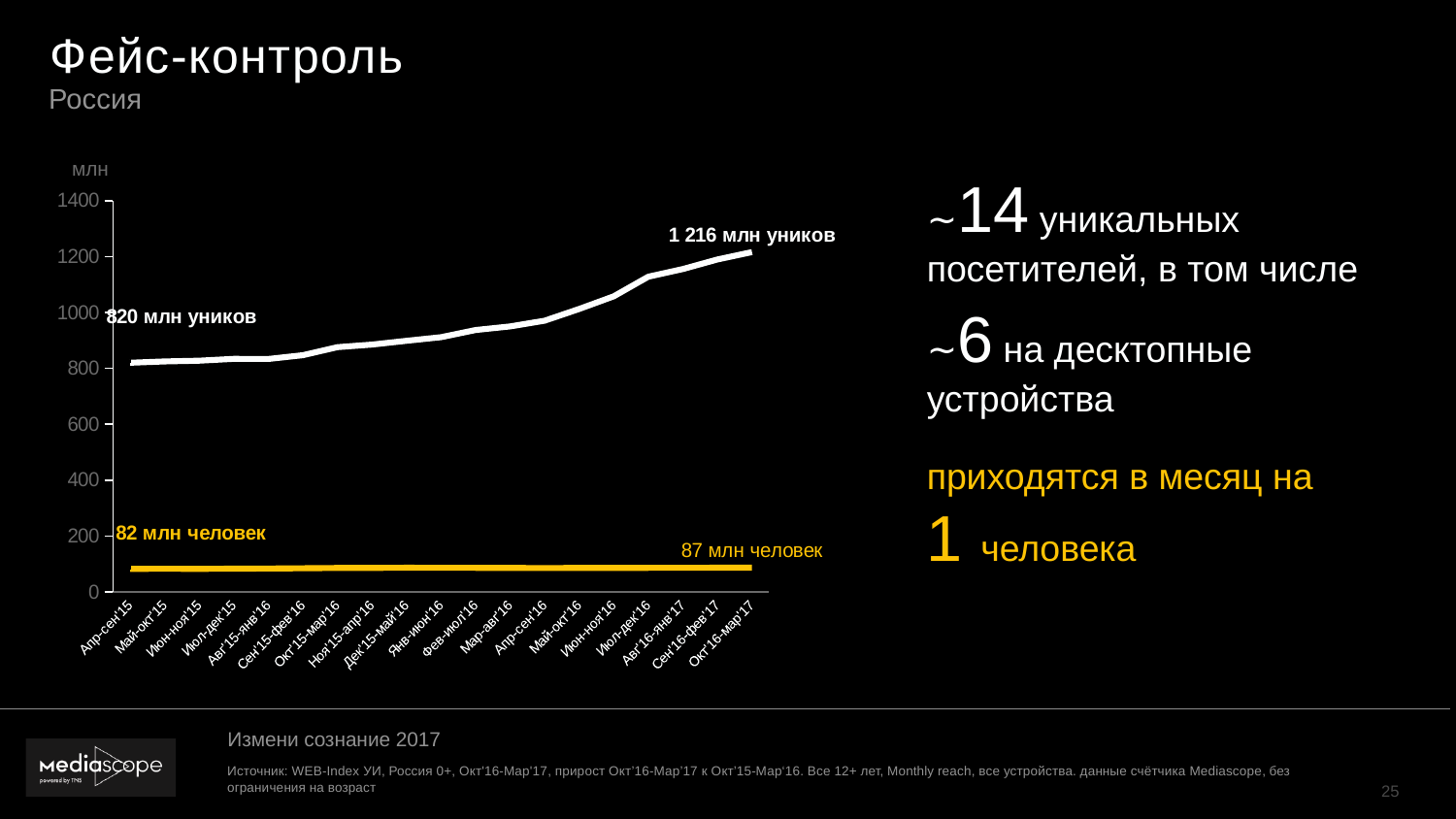
By how much did the number of человек grow from the first labelled value to the last labelled value? 5 млн What kind of chart is shown on the slide? line chart At the end of the period, which is larger: the number of уники or the number of человек? уники What is the value of the yellow line (человек) at the start of the period, Апр-сен'15? 82 млн человек What unit is shown at the top of the y axis? млн What is the value of the yellow line (человек) at the end of the period, Окт'16-мар'17? 87 млн человек By how much did the number of уники grow from the first labelled value to the last labelled value? 396 млн What is the value of the white line (уники) at the start of the period, Апр-сен'15? 820 млн уников What is the value of the white line (уники) at the end of the period, Окт'16-мар'17? 1 216 млн уников Is the value of the white line at Окт'15-мар'16 greater or less than 1000? less Is the value of the white line at Июл-дек'16 greater or less than 1000? greater Does the white line (уники) rise or fall along the x axis? rises